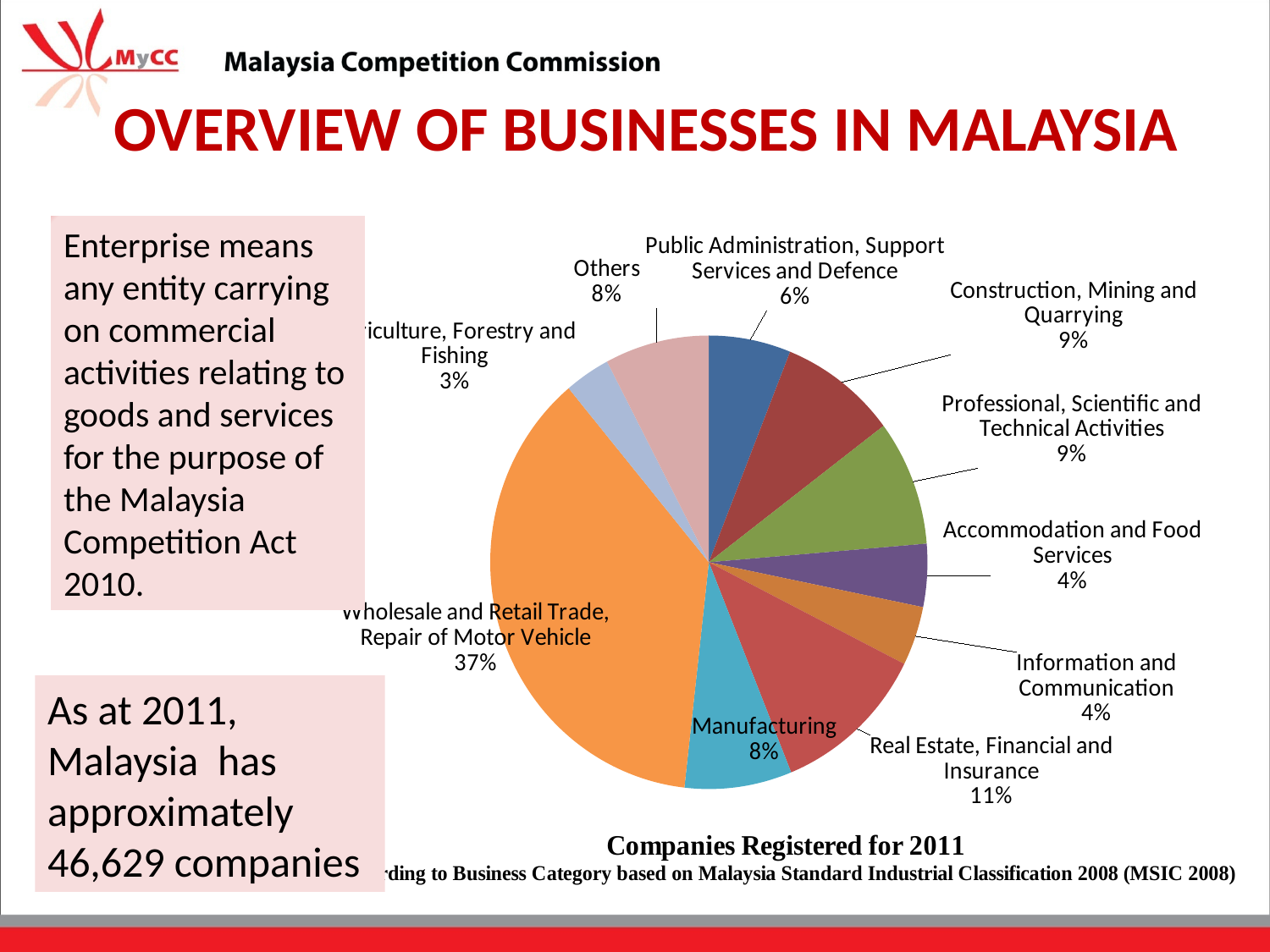
What is the title of the pie chart? Companies Registered for 2011 What percentage is shown for Accommodation and Food Services? 4% Which has a larger share: Construction, Mining and Quarrying or Information and Communication? Construction, Mining and Quarrying What percentage of companies are in Wholesale and Retail Trade, Repair of Motor Vehicle? 37% What kind of chart is shown on the slide? Pie chart What is the difference in percentage points between Wholesale and Retail Trade, Repair of Motor Vehicle and Real Estate, Financial and Insurance? 26 What percentage is shown for Public Administration, Support Services and Defence? 6% Which business category has the largest share of companies registered for 2011? Wholesale and Retail Trade, Repair of Motor Vehicle What percentage of companies are in Real Estate, Financial and Insurance? 11% How many business categories are shown in the pie chart? 10 What share does Manufacturing have in the pie chart? 8% What percentage is shown for Professional, Scientific and Technical Activities? 9%